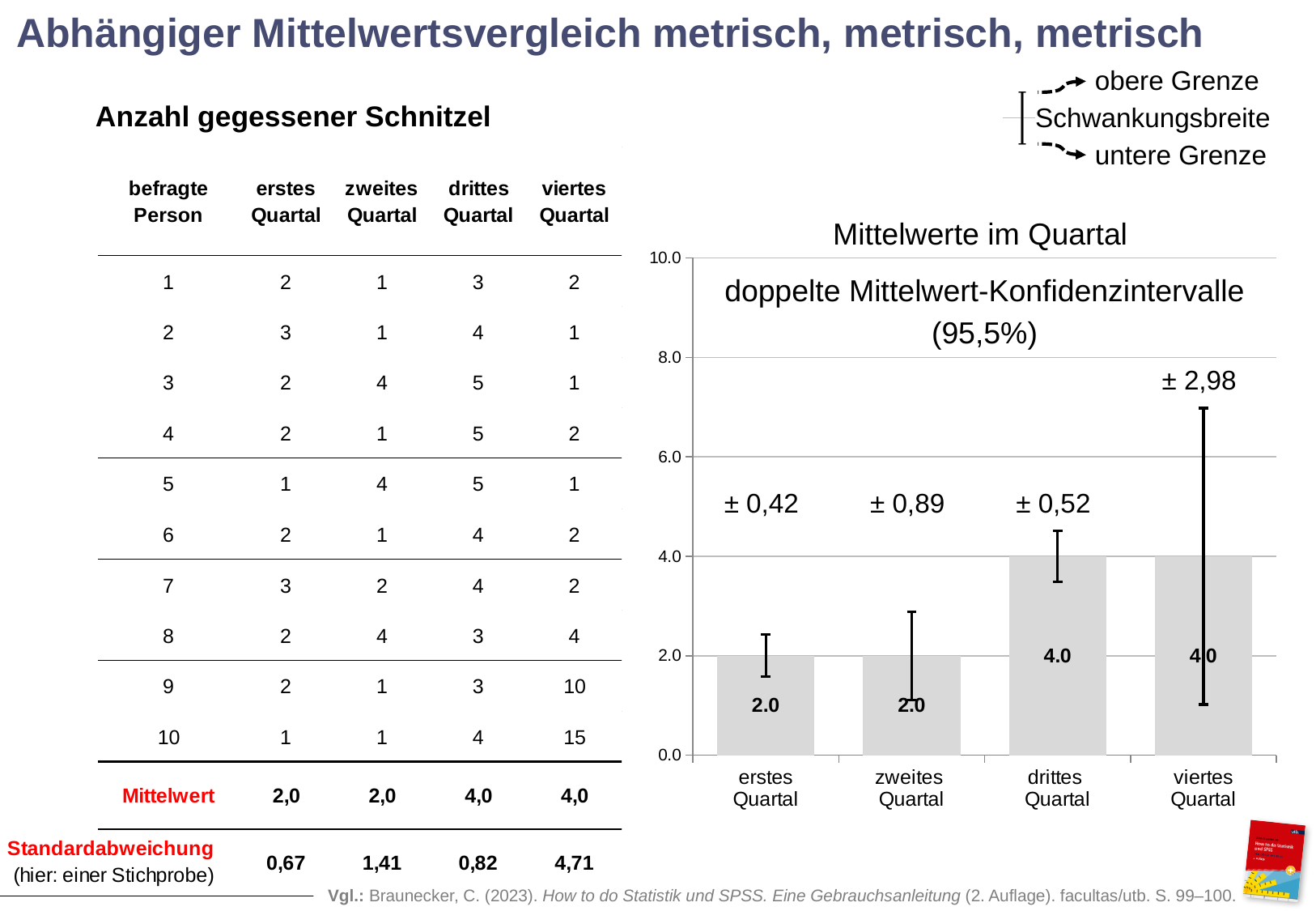
What is the title of the chart? Mittelwerte im Quartal Which bar is larger, zweites Quartal or drittes Quartal? drittes Quartal What is the confidence interval (±) shown above the bar for viertes Quartal? ± 2,98 What type of chart is shown on the slide? bar chart What is the value of the bar for drittes Quartal? 4.0 What is the difference between the bar values for drittes Quartal and erstes Quartal? 2.0 How many bars (categories) does the chart show? 4 Is the value for erstes Quartal greater or less than 4.0? less What is the value of the bar for erstes Quartal? 2.0 What is the value of the bar for viertes Quartal? 4.0 Which quarter has the widest confidence interval (largest ± value)? viertes Quartal What is the confidence interval (±) shown above the bar for zweites Quartal? ± 0,89